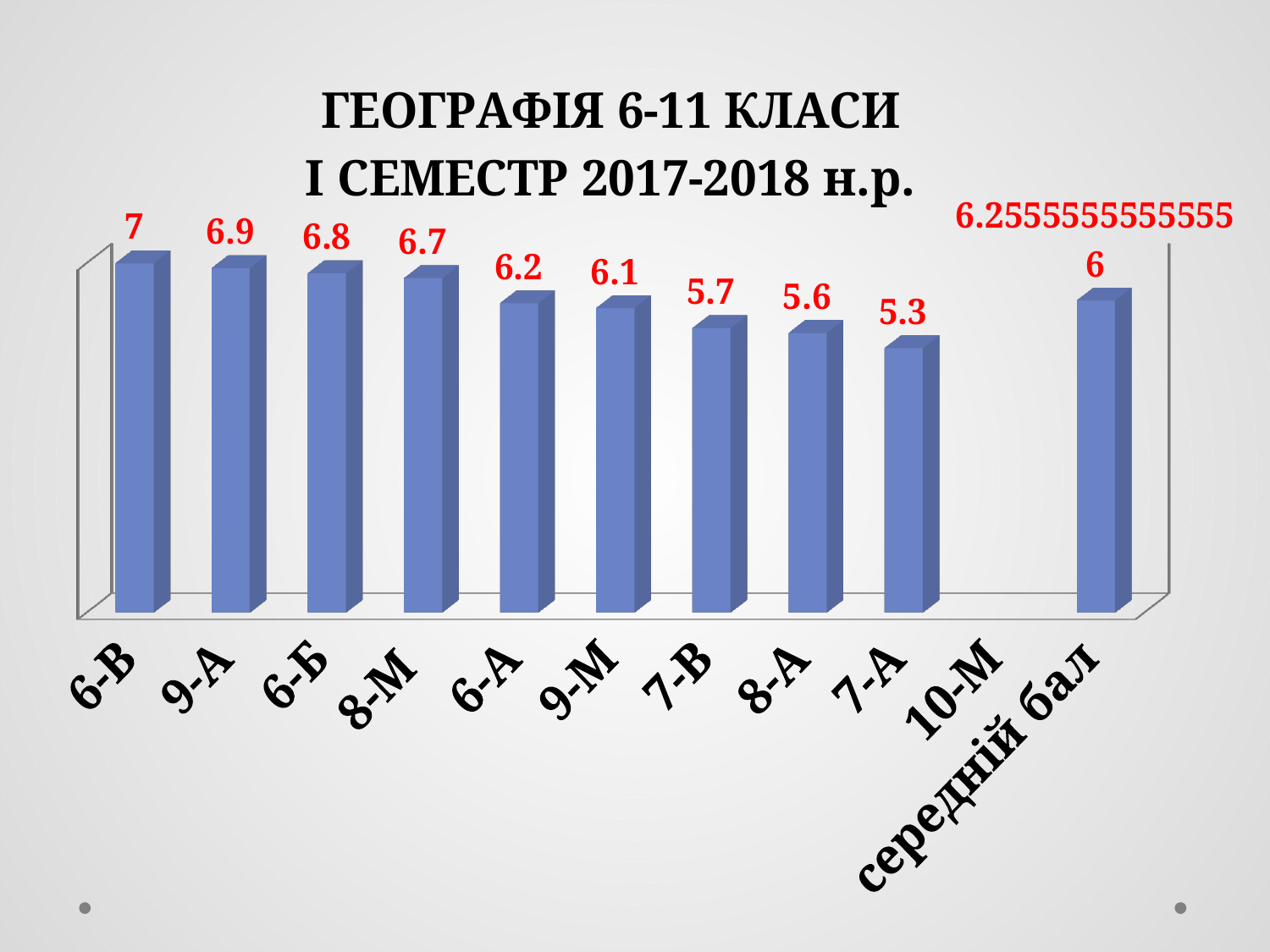
Which class has the lowest value among the bars shown? 7-А Which class has the highest value? 6-В What is the value for 9-М? 6.1 What is the difference between the values for 6-В and 7-А? 1.7 What is the value for 9-А? 6.9 Which is larger, the value for 6-А or the value for 8-А? 6-А Do the values rise or fall from 6-В to 7-А along the x axis? Fall What is the value for 6-В? 7 What is the value for 7-А? 5.3 How many bars are drawn on the chart? 10 What is the value for 8-М? 6.7 What kind of chart is shown? Bar chart